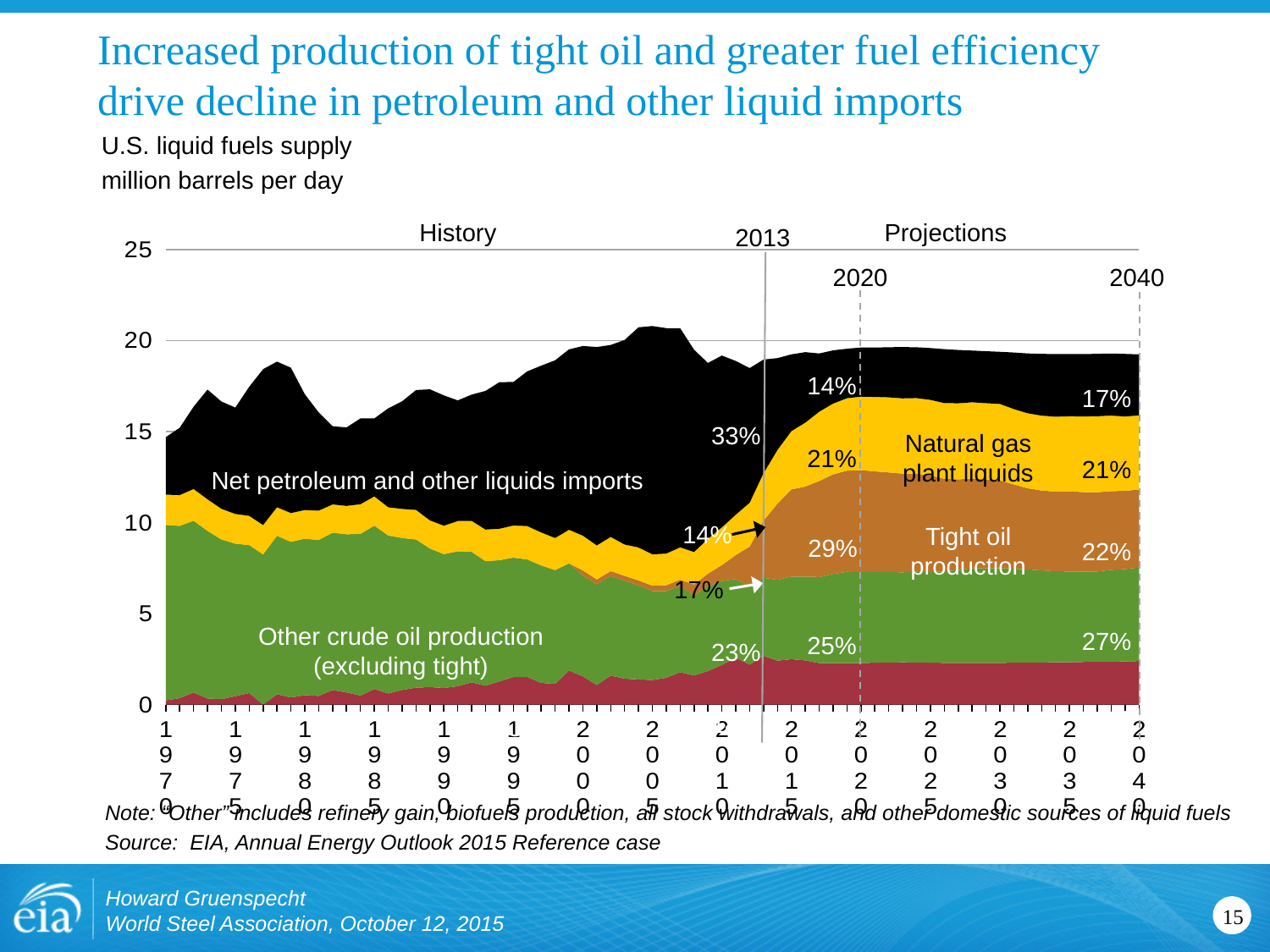
Which labeled component has the smallest share of U.S. liquid fuels supply in 2020? Net petroleum and other liquids imports Which labeled component has the largest share of U.S. liquid fuels supply in 2013? Net petroleum and other liquids imports Which is larger in 2040: the share of tight oil production or the share of other crude oil production (excluding tight)? Other crude oil production (excluding tight) What share of U.S. liquid fuels supply do net petroleum and other liquids imports account for in 2013? 33% What share of U.S. liquid fuels supply is tight oil production projected to account for in 2020? 29% What share of U.S. liquid fuels supply is natural gas plant liquids projected to account for in 2040? 21% What share of U.S. liquid fuels supply is other crude oil production (excluding tight) projected to account for in 2040? 27% What kind of chart is used to show U.S. liquid fuels supply? Stacked area chart What year marks the boundary between History and Projections on the chart? 2013 What share of U.S. liquid fuels supply do net petroleum and other liquids imports account for in 2020? 14% Is total U.S. liquid fuels supply in 2040 greater or less than 20 million barrels per day? less By how many percentage points does the share of net petroleum and other liquids imports fall from 2013 to 2020? 19 percentage points